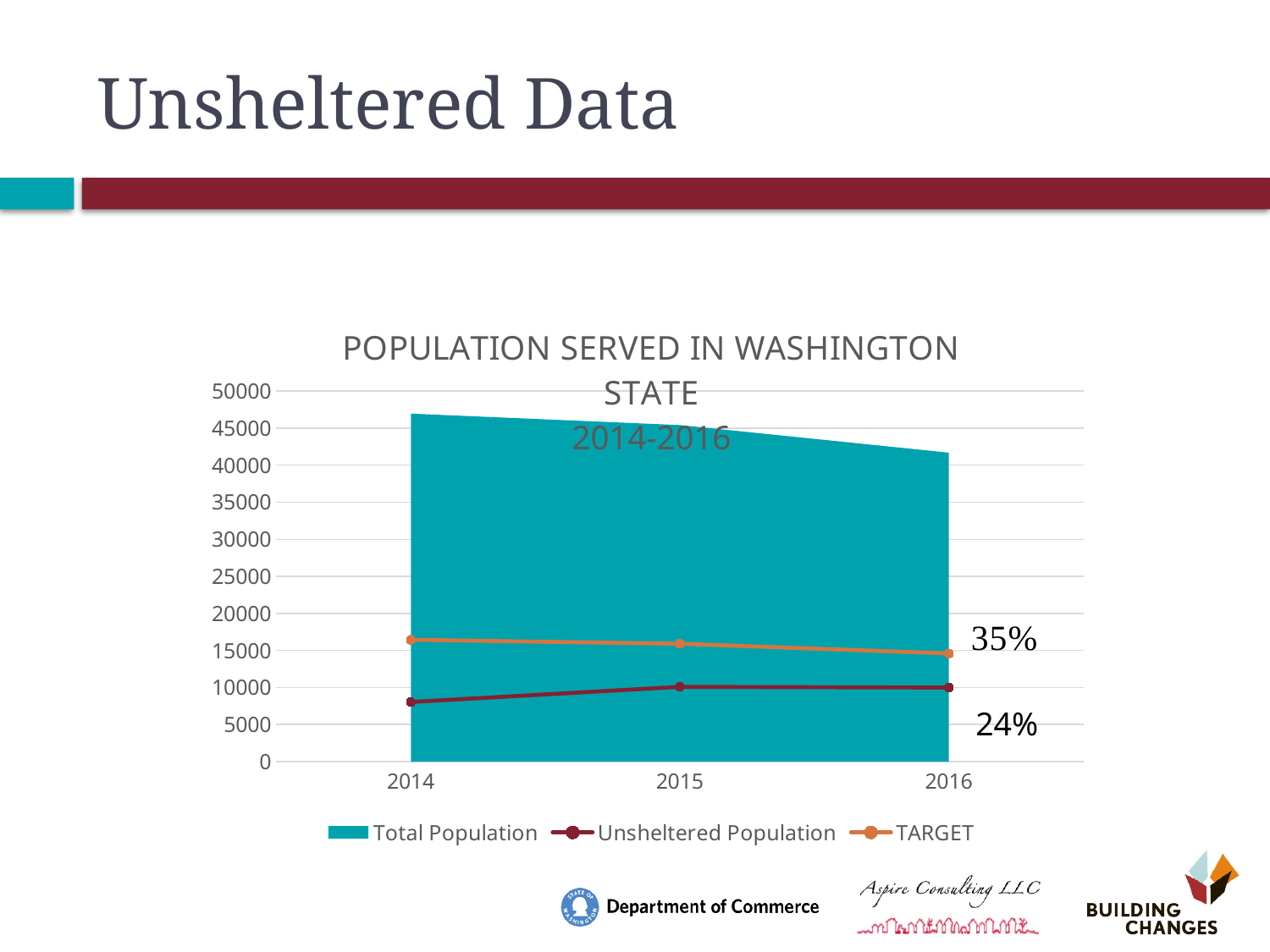
How many years are shown on the x axis of the chart? 3 In which year is the Total Population highest? 2014 How many series does the legend list in the chart? 3 Is the TARGET value for 2014 greater or less than 15000? greater Which series are listed in the chart's legend? Total Population, Unsheltered Population, TARGET Does the TARGET series rise or fall from 2014 to 2016? fall What is the title of the chart? POPULATION SERVED IN WASHINGTON STATE 2014-2016 Does the Total Population rise or fall from 2014 to 2016? fall Is the Total Population value for 2014 greater or less than 45000? greater Is the Total Population value for 2016 greater or less than 45000? less In 2015, which is larger: the TARGET value or the Unsheltered Population value? TARGET